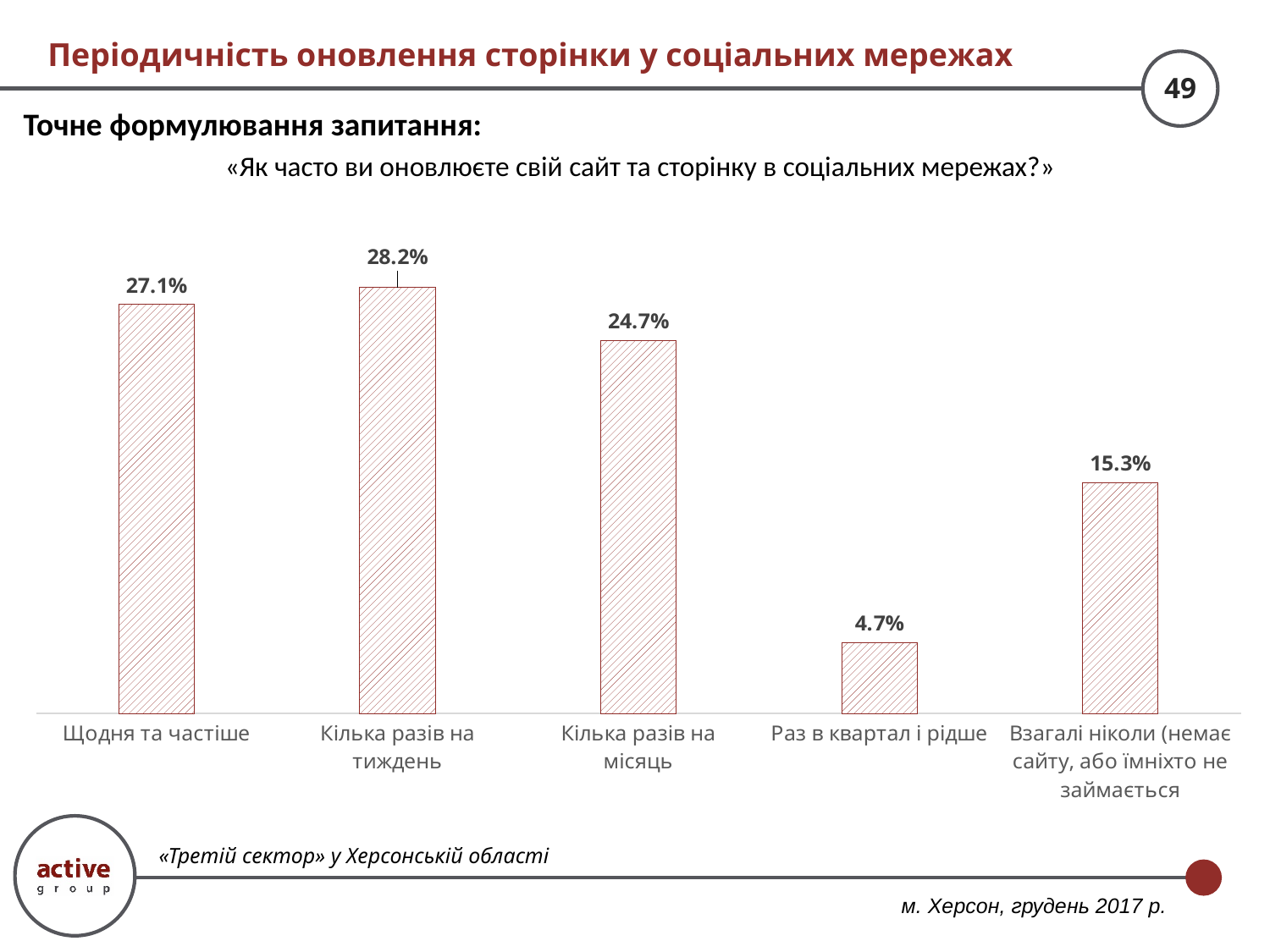
What is the value for «Кілька разів на місяць»? 24.7% Which is larger: the value for «Кілька разів на місяць» or the value for «Взагалі ніколи»? Кілька разів на місяць What is the value for «Щодня та частіше»? 27.1% What is the difference between the values for «Кілька разів на тиждень» and «Щодня та частіше»? 1.1 percentage points What is the value for «Раз в квартал і рідше»? 4.7% What is the value for «Кілька разів на тиждень»? 28.2% How many categories are shown in the chart? 5 What kind of chart is shown on the slide? Bar chart Which category has the lowest value? Раз в квартал і рідше What is the difference between the values for «Взагалі ніколи» and «Раз в квартал і рідше»? 10.6 percentage points Which category has the highest value? Кілька разів на тиждень What is the value for «Взагалі ніколи (немає сайту, або їм ніхто не займається)»? 15.3%